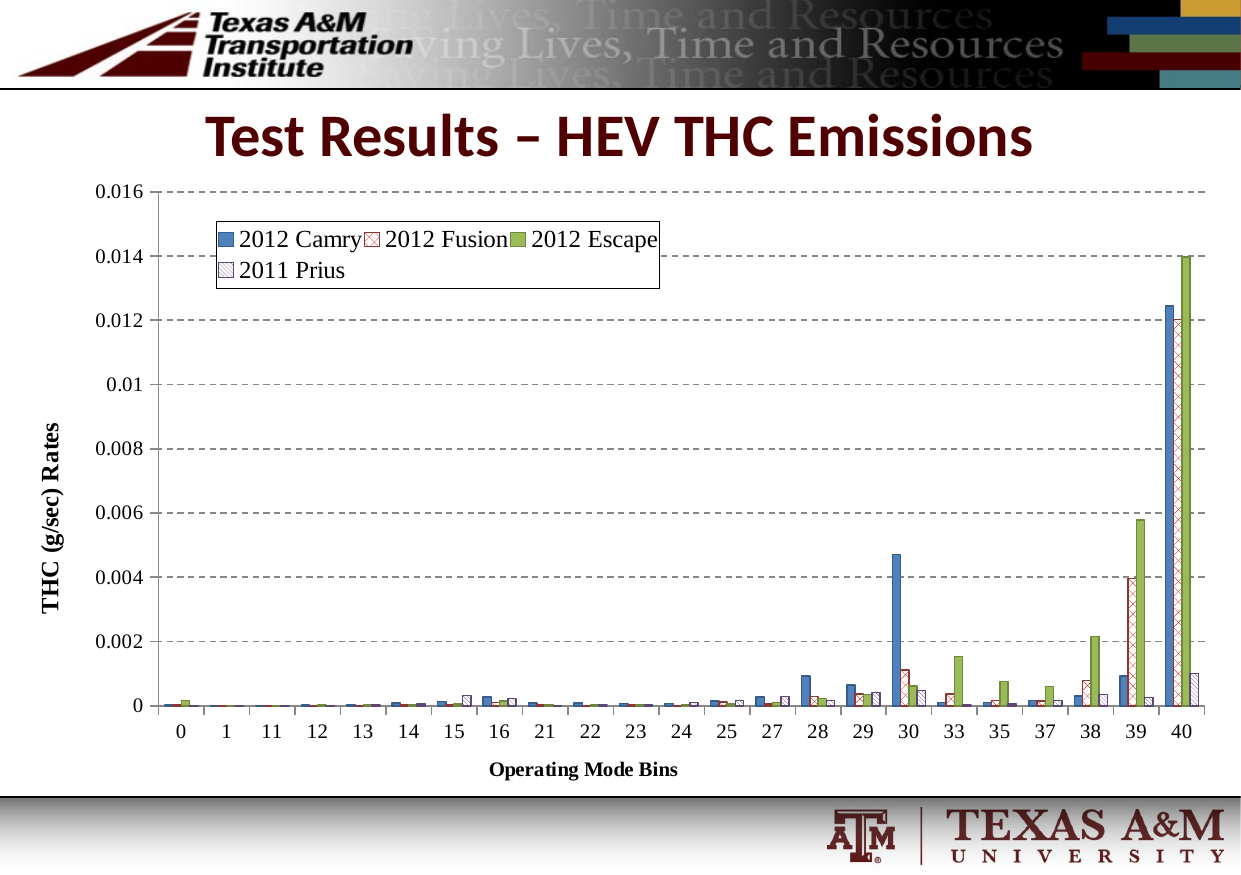
What kind of chart is shown on the slide? bar chart Is the value for 2012 Escape at bin 38 greater or less than 0.004? less How many series does the legend list? 4 Is the value for 2012 Camry at bin 30 greater or less than 0.004? greater Which series has the highest value at operating mode bin 30? 2012 Camry Is the value for 2012 Camry at bin 40 greater or less than 0.01? greater How many operating mode bins are shown on the x axis? 23 Which operating mode bin has the highest value for 2012 Escape? 40 What is the label of the y axis? THC (g/sec) Rates At operating mode bin 39, which is larger: 2012 Escape or 2012 Fusion? 2012 Escape Which series has the highest value at operating mode bin 40? 2012 Escape